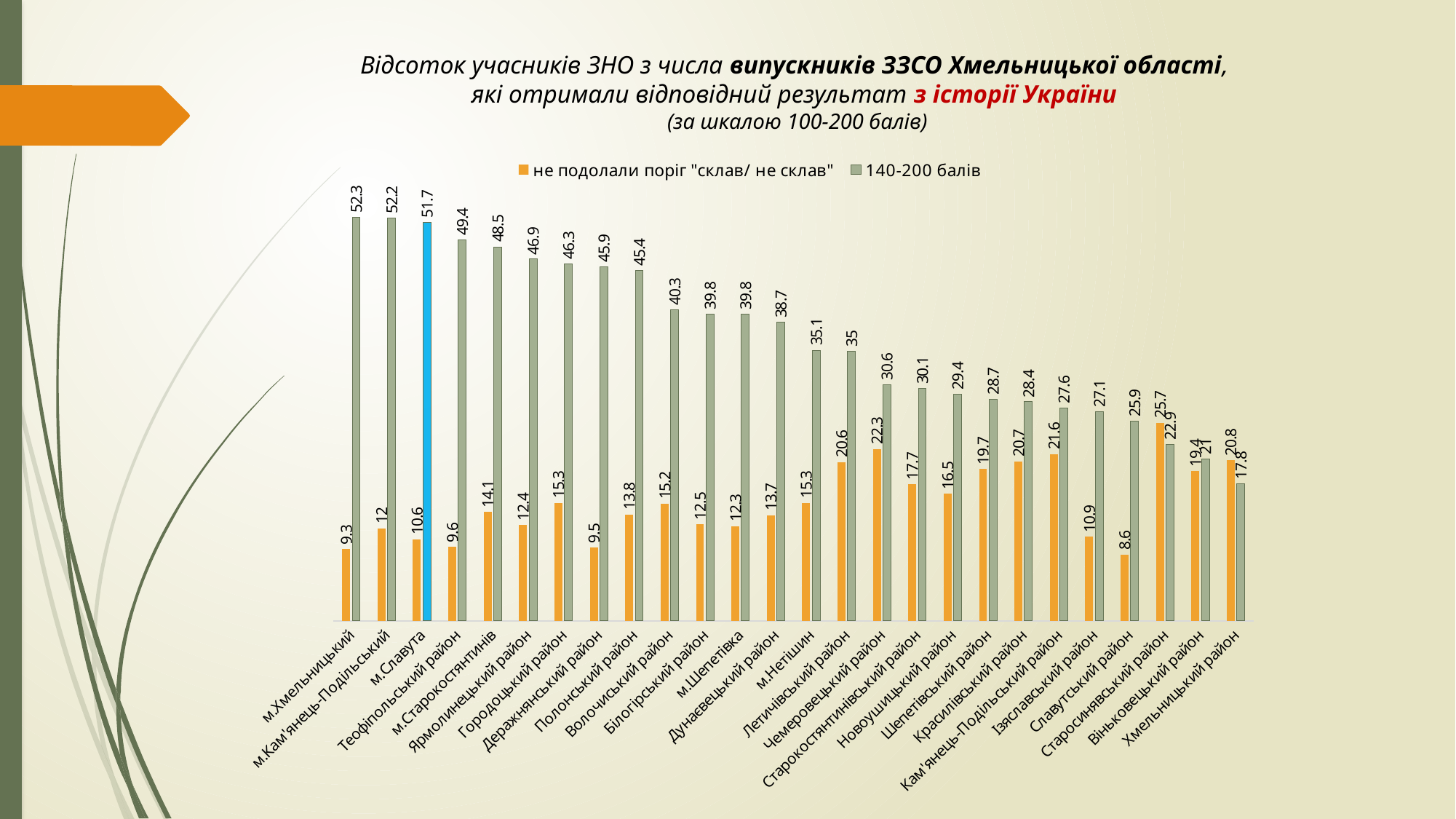
What is the value of the "140-200 балів" series for м.Хмельницький? 52.3 What is the difference between the "140-200 балів" value and the "не подолали поріг" value for м.Хмельницький? 43 Which category has the highest value in the "не подолали поріг "склав/ не склав"" series? Старосинявський район How many series does the legend list? 2 What is the value of the "не подолали поріг "склав/ не склав"" series for Старосинявський район? 25.7 Which category has the lowest value in the "140-200 балів" series? Хмельницький район Do the values of the "140-200 балів" series rise or fall from left to right along the x axis? Fall What kind of chart is shown on the slide? Bar chart How many categories are shown on the x axis? 26 Which category has the lowest value in the "не подолали поріг "склав/ не склав"" series? Славутський район What is the value of the "140-200 балів" series for м.Славута? 51.7 For Хмельницький район, which is larger: the "не подолали поріг" value or the "140-200 балів" value? не подолали поріг (20.8)